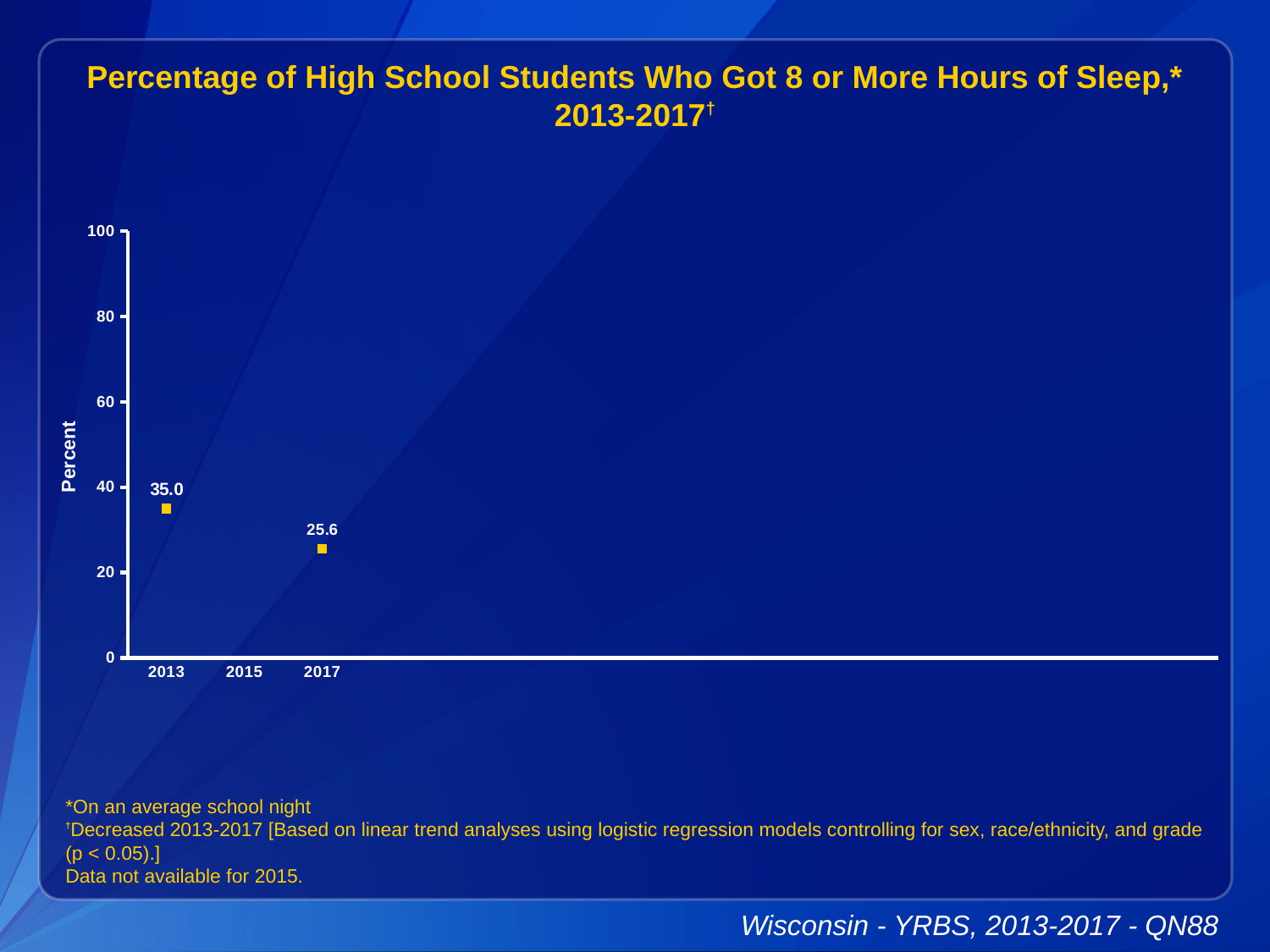
What is the value for 2017? 25.6 Which is larger, the value for 2013 or the value for 2017? 2013 Which year has the lowest plotted value? 2017 What is the label of the y axis? Percent What is the difference between the values for 2013 and 2017? 9.4 How many data points are plotted on the chart? 2 Is the value for 2013 greater or less than 40? less Is the value for 2017 greater or less than 20? greater Which year has the highest value? 2013 Which year on the x axis has no data plotted? 2015 What is the value for 2013? 35.0 Do the values rise or fall from 2013 to 2017? fall